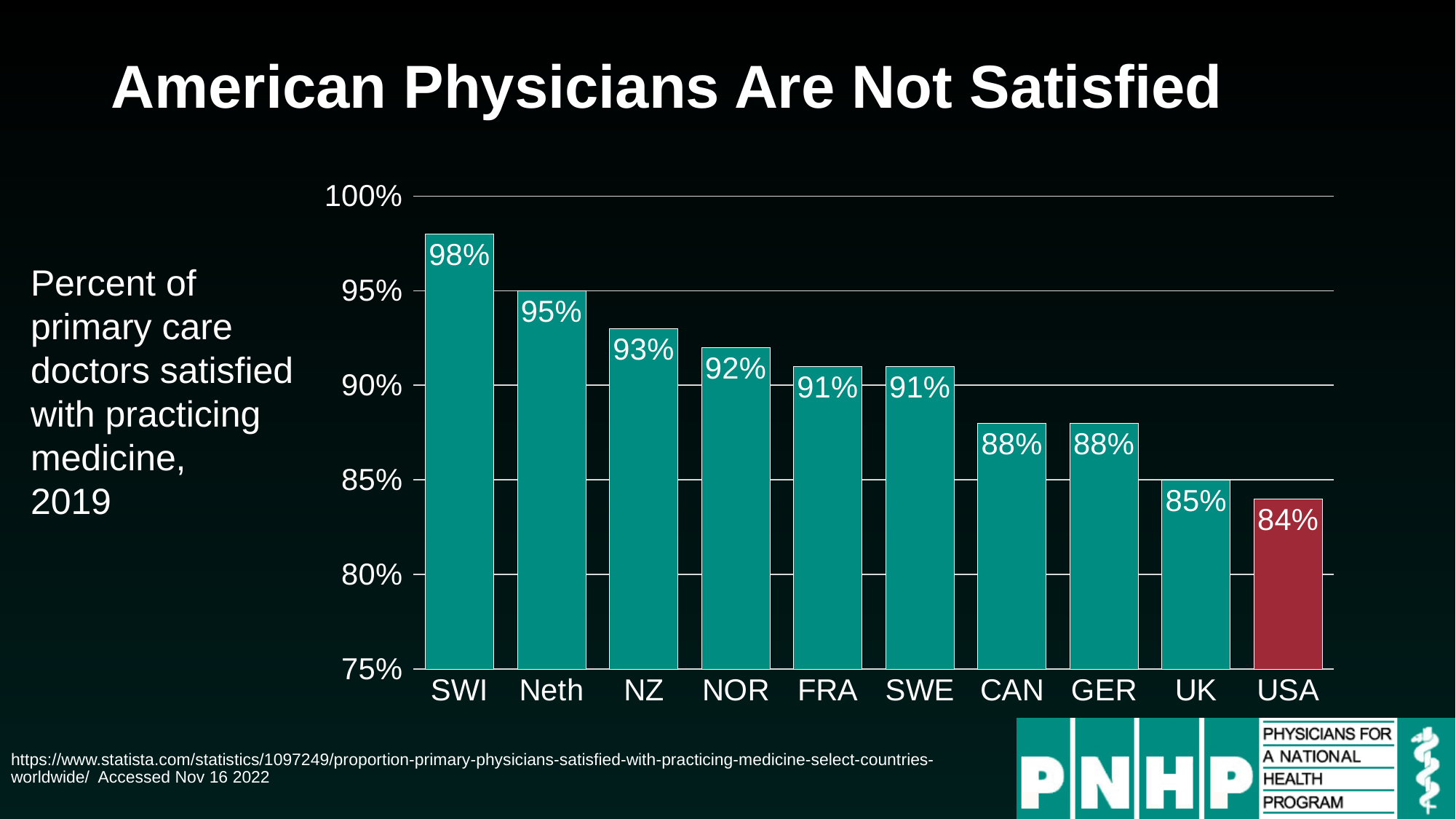
Which has a higher value, NZ or GER? NZ Do the values rise or fall from left to right across the chart? Fall What is the difference between the values for SWI and USA? 14% Which country has the highest percentage of satisfied primary care doctors? SWI Which country has the lowest percentage of satisfied primary care doctors? USA What percent of primary care doctors in the USA are satisfied with practicing medicine? 84% What kind of chart is shown on the slide? Bar chart What is the value shown for SWI? 98% How many countries are shown on the chart? 10 What is the difference between the values for Neth and UK? 10% What is the value shown for CAN? 88% Which bar is shown in a different colour (red) from the others? USA